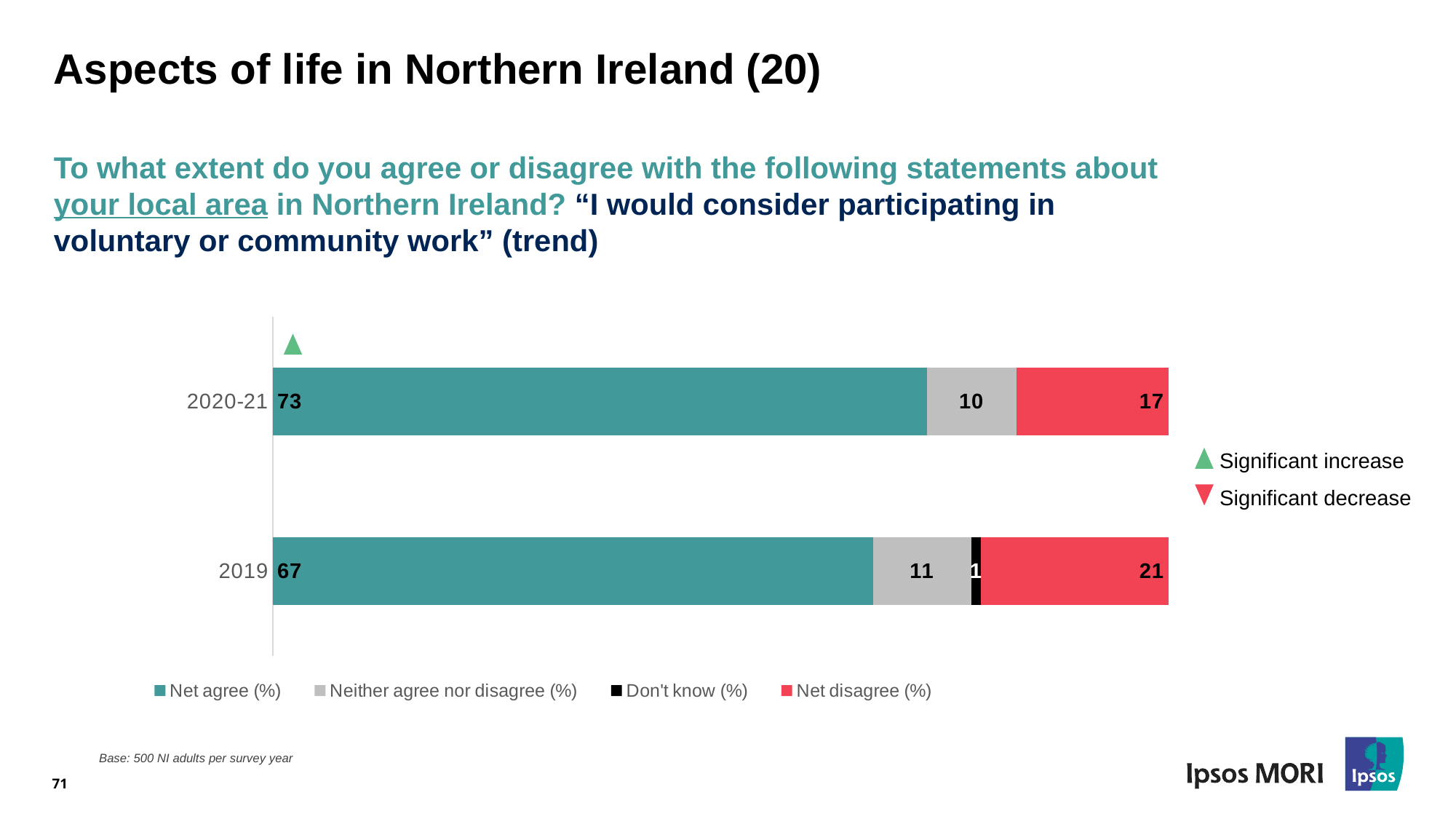
What is the total of the labelled segments in the 2019 bar? 100 How many years are shown on the chart? 2 What is the difference between the Net agree (%) values for 2020-21 and 2019? 6 Which year has the higher Net agree (%) value? 2020-21 What is the Net agree (%) value for 2020-21? 73 Which year has the lower Net disagree (%) value? 2020-21 What is the Net disagree (%) value for 2019? 21 What is the Don't know (%) value for 2019? 1 What is the Neither agree nor disagree (%) value for 2020-21? 10 Is the Net disagree (%) value larger for 2019 or for 2020-21? 2019 How many series does the chart legend list? 4 What kind of chart is shown on the slide? Stacked bar chart